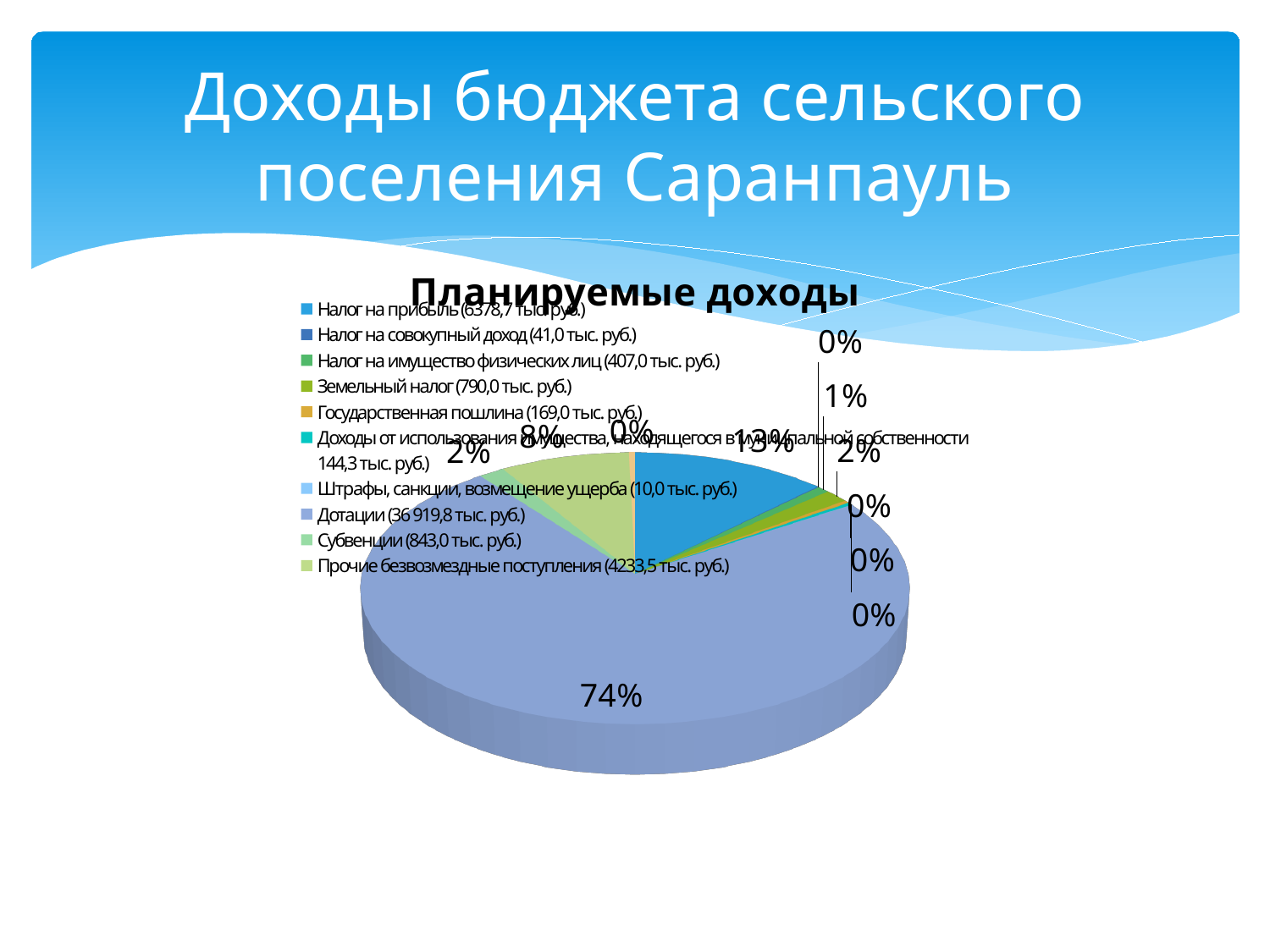
What share of the pie is labelled for Налог на прибыль? 13% By how many percentage points does the Дотации slice (74%) exceed the Налог на прибыль slice (13%)? 61 Which is larger: the slice for Дотации or the slice for Налог на прибыль? Дотации What is the title of the chart? Планируемые доходы How many categories does the chart's legend list? 10 What share of the pie does the largest slice (Дотации) take? 74% Which category has the largest slice of the pie? Дотации What amount is given in the legend for Дотации? 36 919,8 тыс. руб. Is the share of the Дотации slice greater or less than 50%? greater What amount is given in the legend for Прочие безвозмездные поступления? 4233,5 тыс. руб. What kind of chart is shown on the slide? pie chart What amount is given in the legend for Налог на прибыль? 6378,7 тыс. руб.